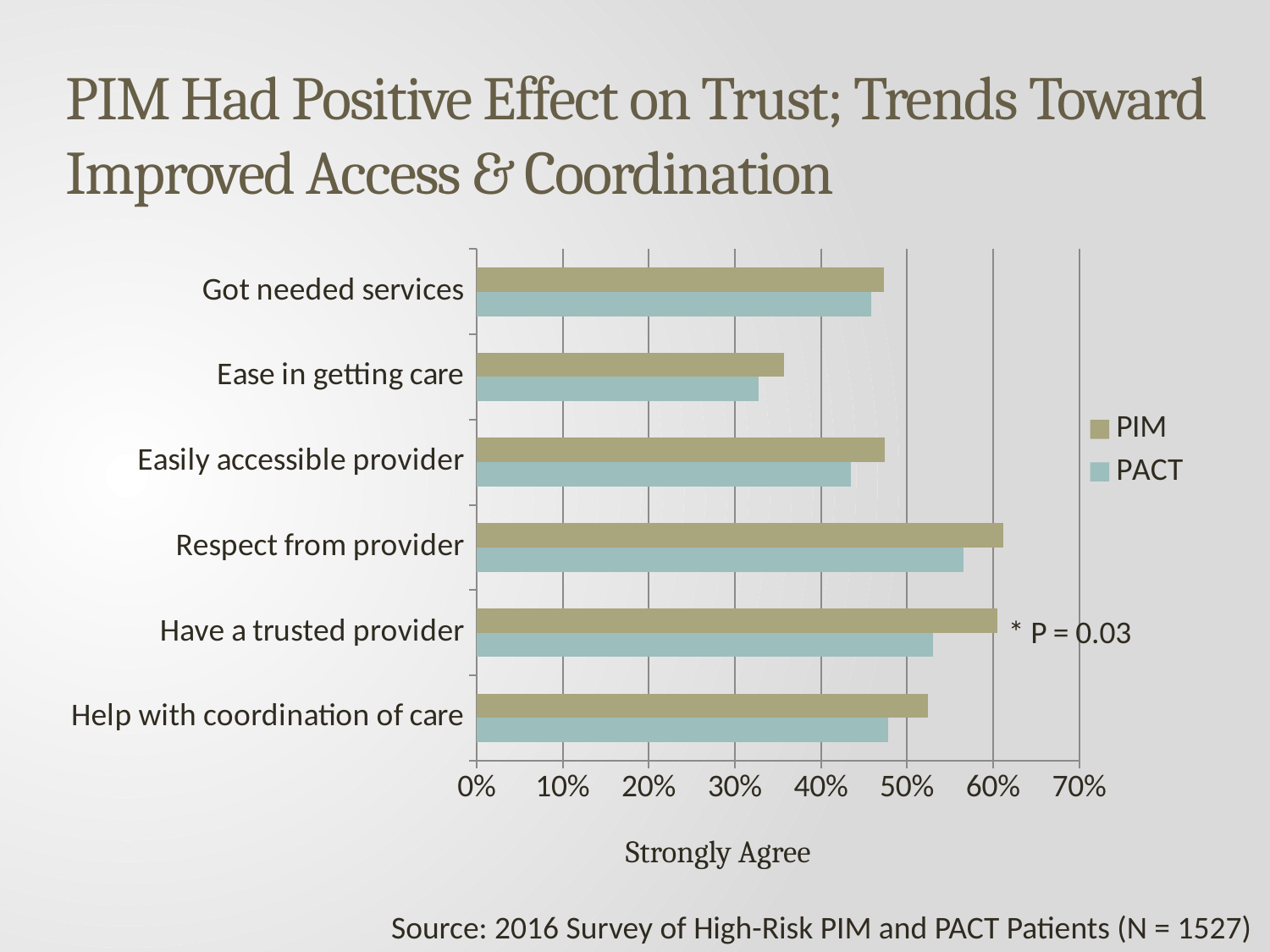
What P value is annotated next to the Have a trusted provider bars? P = 0.03 How many categories are shown on the chart? 6 Is the PIM value for Help with coordination of care greater or less than 50%? greater Is the PACT value for Respect from provider greater or less than 50%? greater Which category has the lowest PACT value? Ease in getting care Which category has the highest PACT value? Respect from provider For Have a trusted provider, which series has the larger value, PIM or PACT? PIM Which category has the lowest PIM value? Ease in getting care How many series does the legend list? 2 Is the PIM value for Ease in getting care greater or less than 40%? less What is the title of the horizontal axis? Strongly Agree What kind of chart is shown on the slide? Bar chart